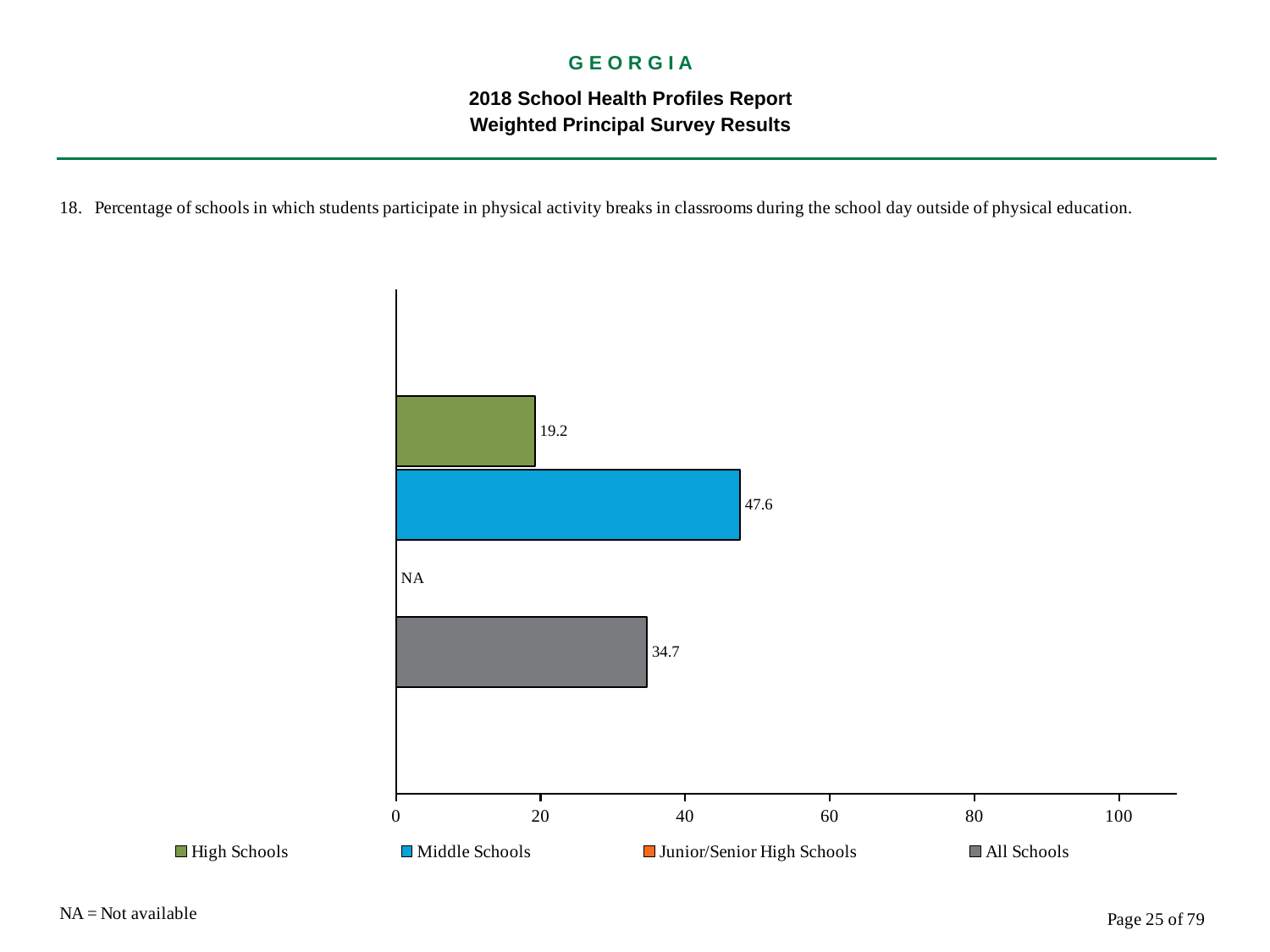
What is the value for All Schools? 34.7 Which school type has the highest value? Middle Schools What is the value for High Schools? 19.2 Which school type with a plotted bar has the lowest value? High Schools Is the value for Middle Schools greater or less than 40? greater What kind of chart is shown on the slide? bar chart Which is larger, the value for All Schools or the value for High Schools? All Schools What is the value for Middle Schools? 47.6 How many series does the legend list? 4 What is shown for Junior/Senior High Schools? NA What is the difference between the Middle Schools value and the High Schools value? 28.4 What is the difference between the Middle Schools value and the All Schools value? 12.9